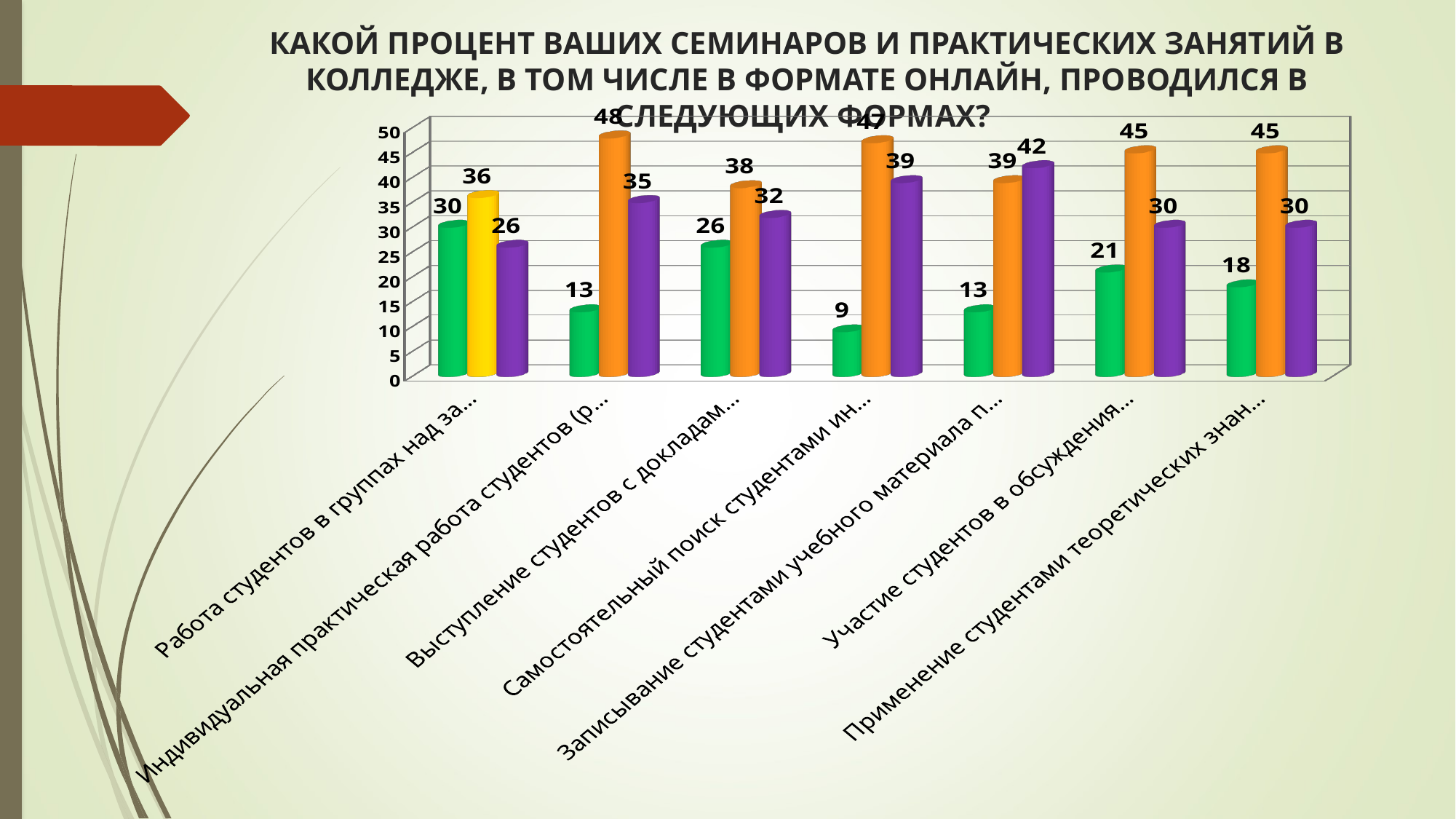
Which category has the lowest green bar? Самостоятельный поиск студентами ин... What is the value of the yellow bar for the category beginning "Работа студентов в группах"? 36 What is the difference between the purple bars of the categories beginning "Самостоятельный поиск студентами" and "Выступление студентов с докладам"? 7 What is the value of the green bar for the category beginning "Самостоятельный поиск студентами"? 9 What kind of chart is shown on the slide? bar chart For the category beginning "Записывание студентами учебного материала", which is larger: the orange bar or the purple bar? the purple bar What is the value of the purple bar for the category beginning "Записывание студентами учебного материала"? 42 What is the difference between the orange bar and the green bar for the category beginning "Участие студентов в обсуждения"? 24 What is the highest value shown on the vertical axis of the chart? 50 Which category has the highest green bar? Работа студентов в группах над за... How many categories are shown along the x axis of the chart? 7 What is the value of the orange bar for the category beginning "Индивидуальная практическая работа студентов"? 48